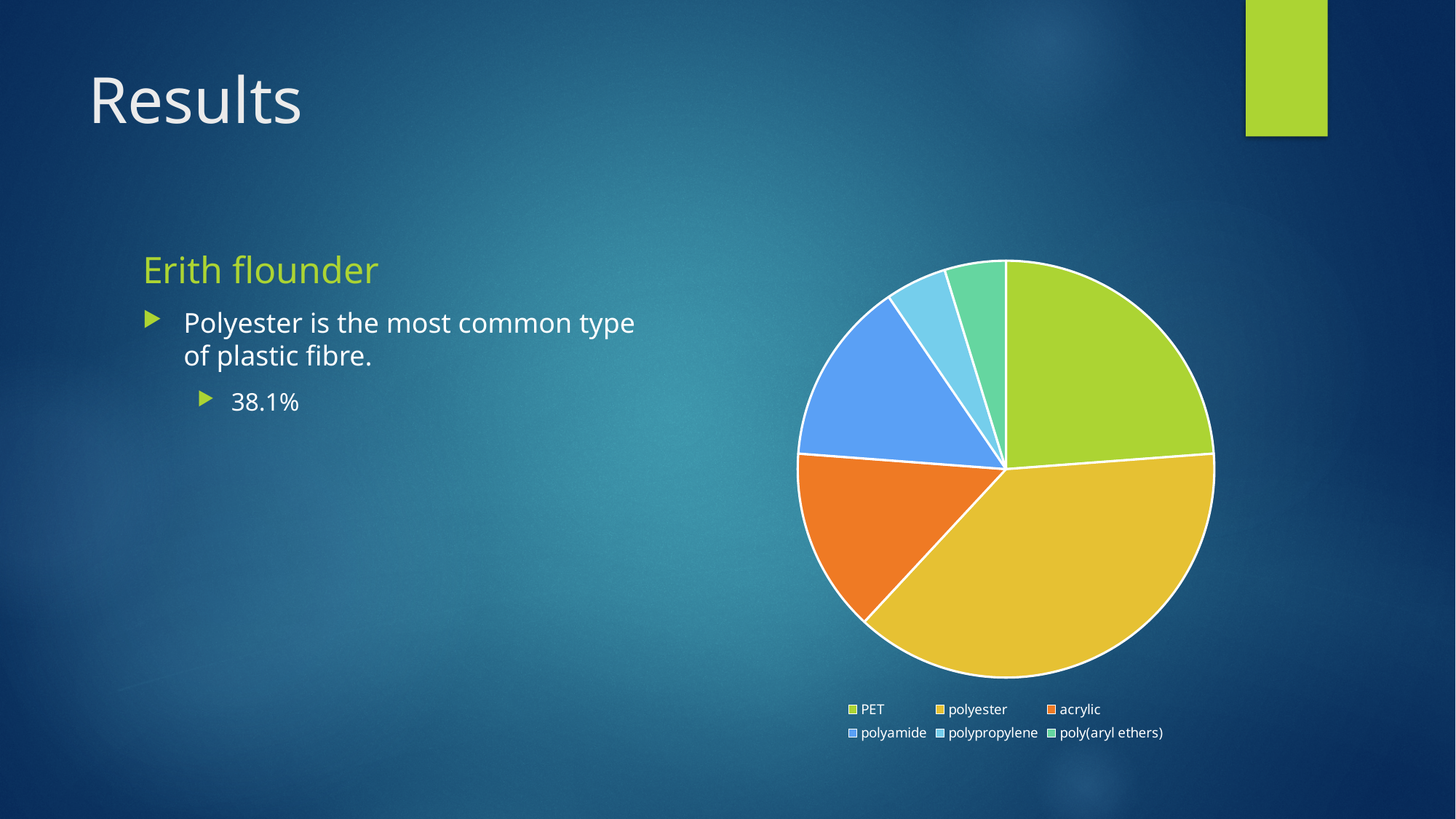
Which slice is larger, polyester or PET? polyester Which slice is larger, PET or polyamide? PET What is the heading above the bullet text describing the chart? Erith flounder What kind of chart is shown on the slide? pie chart How many categories does the pie chart show? 6 Which slice is larger, PET or acrylic? PET Which category is shown in orange in the pie chart? acrylic Which category has the largest slice of the pie chart? polyester What share of the pie does polyester account for, according to the slide? 38.1%